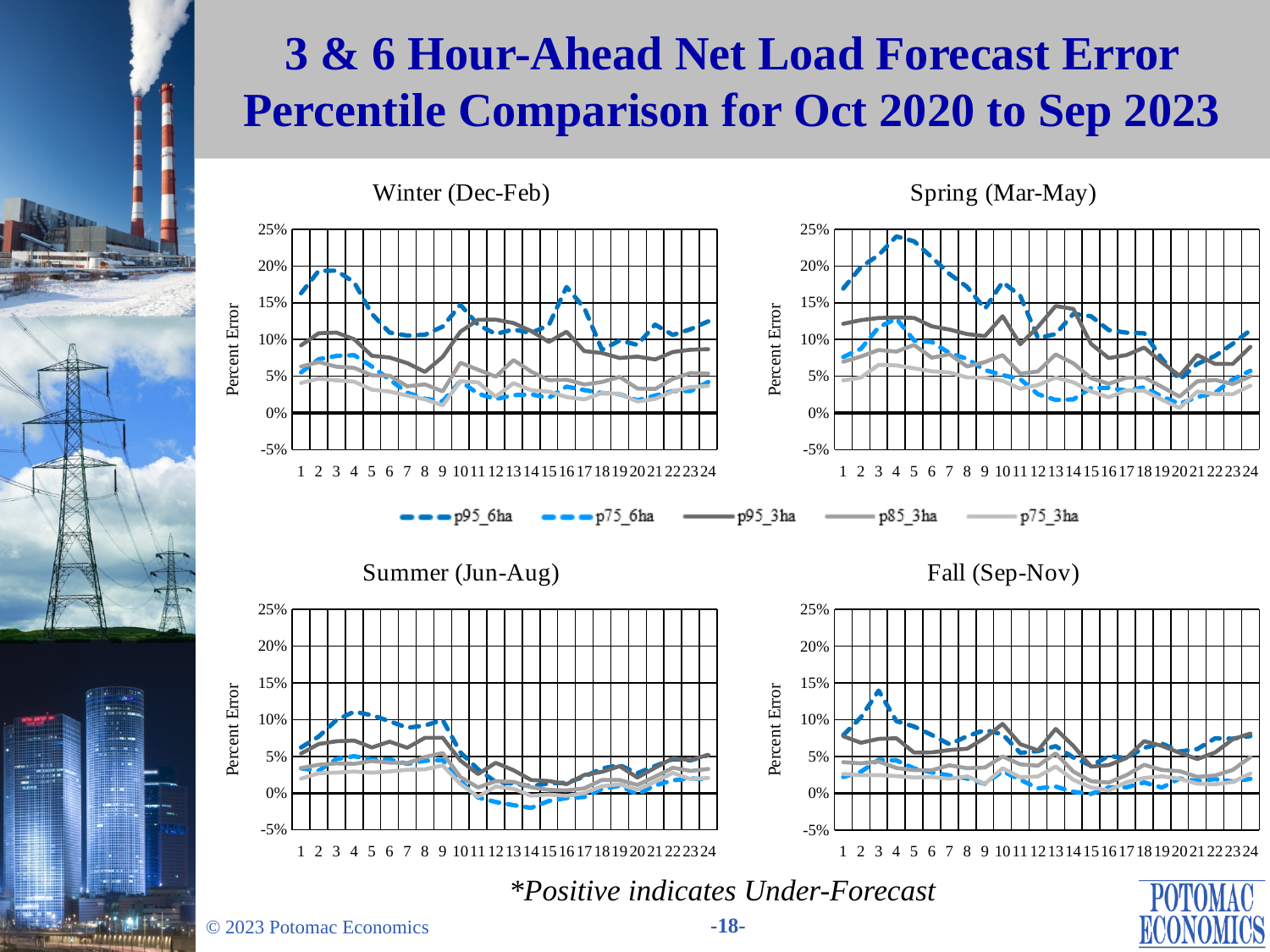
Which of the four seasonal charts reaches the highest peak value? Spring (Mar-May) According to the footnote below the charts, what does a positive value indicate? Under-Forecast How many points are plotted along the x axis of the Summer (Jun-Aug) chart? 24 In the Spring (Mar-May) chart, which is larger at hour 4: p95_6ha or p95_3ha? p95_6ha How many series does the shared legend list for the four charts? 5 What kind of chart is the Winter (Dec-Feb) chart? Line chart What is the y-axis label on the Fall (Sep-Nov) chart? Percent Error In the Winter (Dec-Feb) chart, is the value of p95_6ha at hour 3 greater or less than 15%? greater In the Summer (Jun-Aug) chart, is the value of p75_6ha at hour 14 greater or less than 0%? less In the Fall (Sep-Nov) chart, is the value of p95_6ha at hour 3 greater or less than 10%? greater